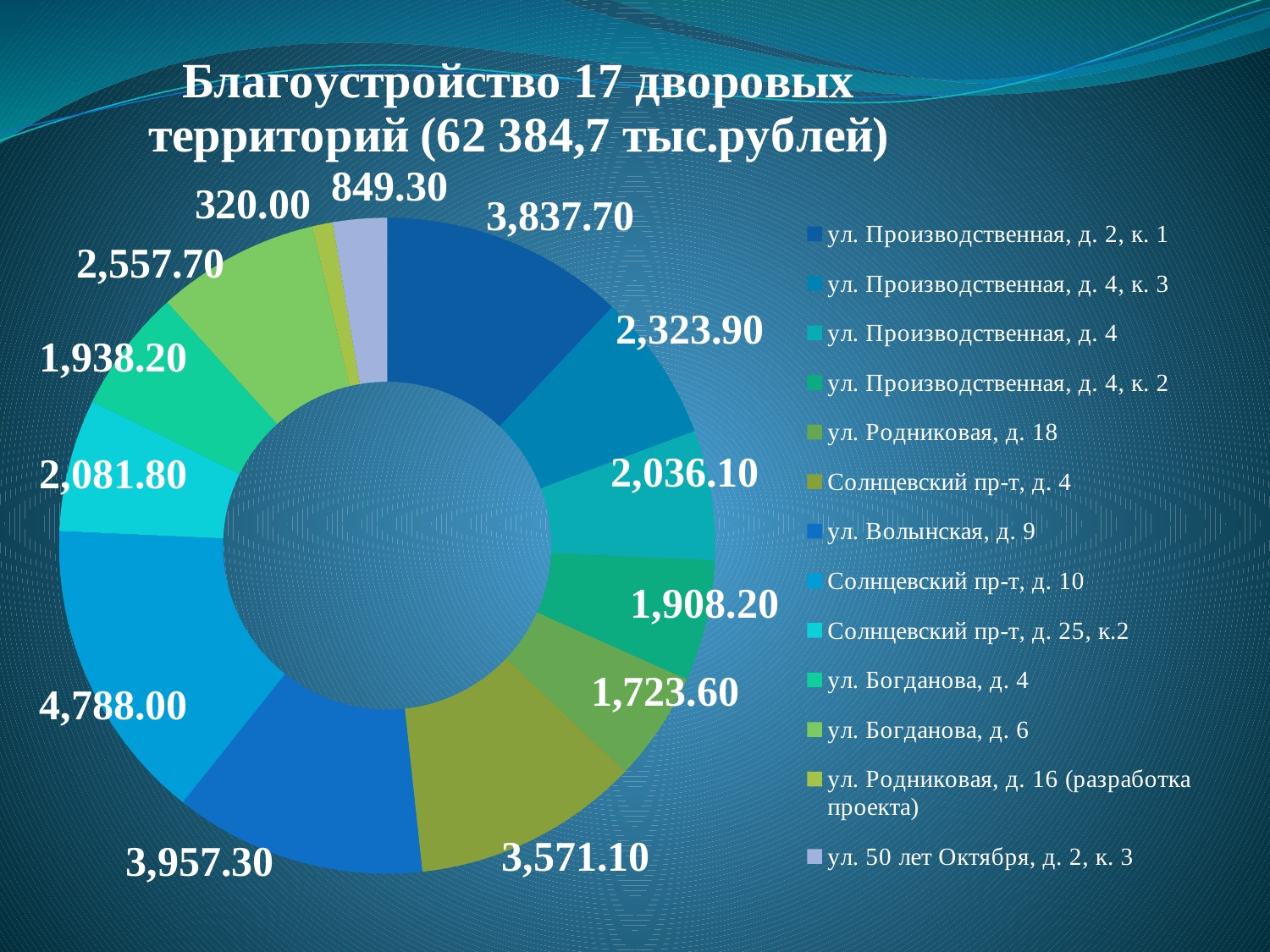
How many categories does the legend list? 13 What is the smallest value shown on the chart? 320.00 Which category has the largest slice? Солнцевский пр-т, д. 10 Which category has the smallest slice? ул. Родниковая, д. 16 (разработка проекта) What is the largest value shown on the chart? 4,788.00 What is the difference between the largest value (4,788.00) and the smallest value (320.00)? 4,468.00 What is the value for ул. 50 лет Октября, д. 2, к. 3? 849.30 What is the value for ул. Производственная, д. 2, к. 1? 3,837.70 What is the value for ул. Волынская, д. 9? 3,957.30 What total amount in thousand rubles is stated in the chart title? 62 384,7 тыс.рублей Which is larger: the slice labelled 3,957.30 or the slice labelled 3,837.70? 3,957.30 What kind of chart is shown on the slide? Doughnut (pie) chart